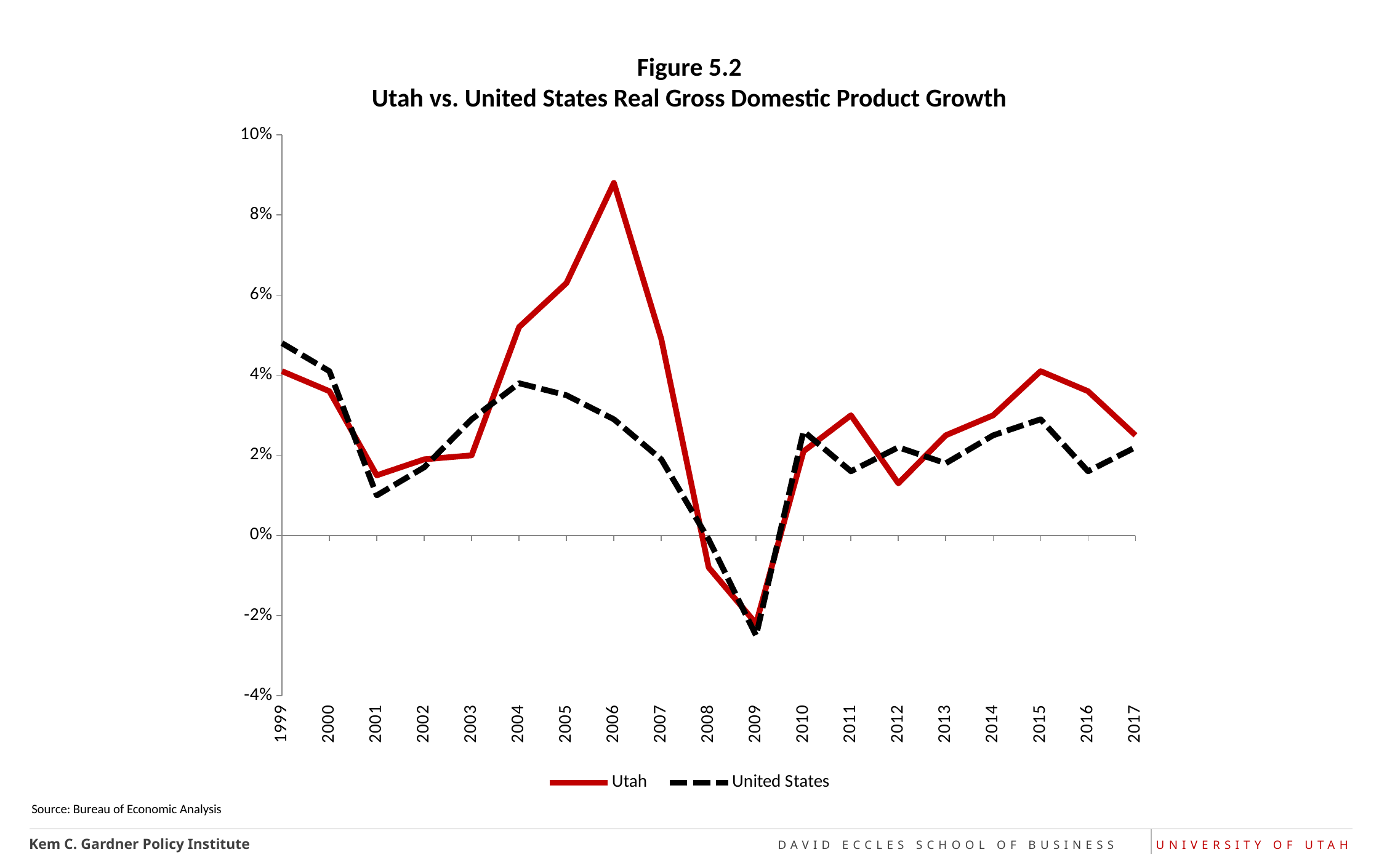
Is the value for Utah in 2006 greater or less than 8%? greater How many series does the legend list? 2 Is the value for Utah in 2004 greater or less than 4%? greater In which year does the Utah series reach its lowest value? 2009 In 2016, which series has the larger value, Utah or United States? Utah What kind of chart is shown on the slide? Line chart Does the Utah series rise or fall from 2006 to 2009? Fall In 1999, which series has the larger value, Utah or United States? United States How many years are plotted along the x axis? 19 In which year does the United States series reach its highest value? 1999 In which year does the Utah series reach its highest value? 2006 Is the value for the United States in 2009 greater or less than -2%? less